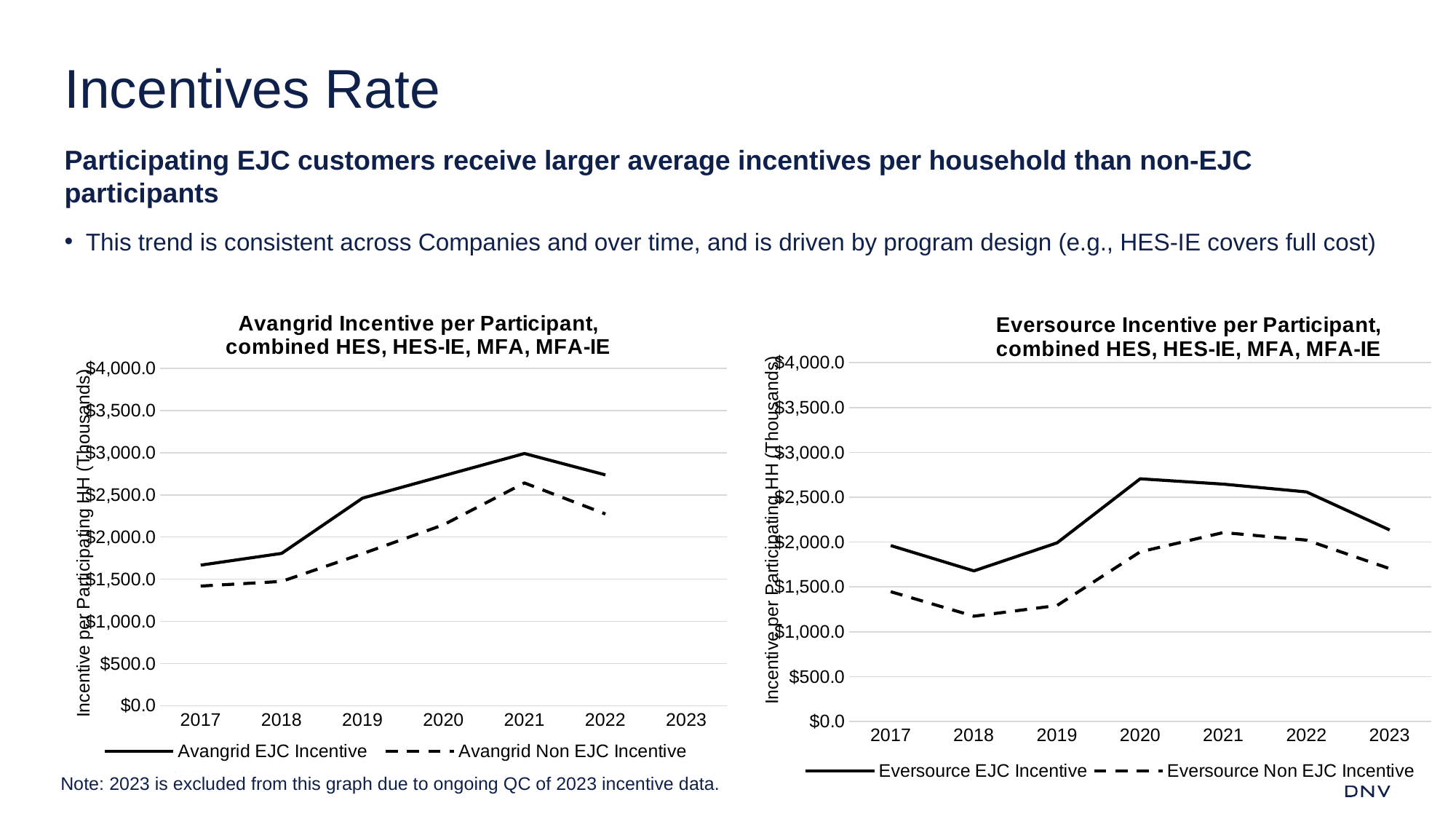
In the Eversource Incentive per Participant chart, is the Eversource Non EJC Incentive for 2018 greater or less than $1,500.0? less What kind of chart is the Avangrid Incentive per Participant chart on the left? line chart In the Avangrid Incentive per Participant chart, which is larger in 2019: the Avangrid EJC Incentive or the Avangrid Non EJC Incentive? Avangrid EJC Incentive In the Avangrid Incentive per Participant chart, in which year is the Avangrid EJC Incentive highest? 2021 In the Avangrid Incentive per Participant chart, does the Avangrid Non EJC Incentive rise or fall from 2017 to 2021? rise In the Eversource Incentive per Participant chart, in which year is the Eversource EJC Incentive highest? 2020 In the Eversource Incentive per Participant chart, in which year is the Eversource Non EJC Incentive lowest? 2018 In the Eversource Incentive per Participant chart, is the Eversource EJC Incentive for 2020 greater or less than $2,500.0? greater In the Avangrid Incentive per Participant chart, is the Avangrid EJC Incentive for 2021 greater or less than $2,500.0? greater In the Eversource Incentive per Participant chart, how many years are shown on the x axis? 7 How many series does the legend of the Avangrid Incentive per Participant chart list? 2